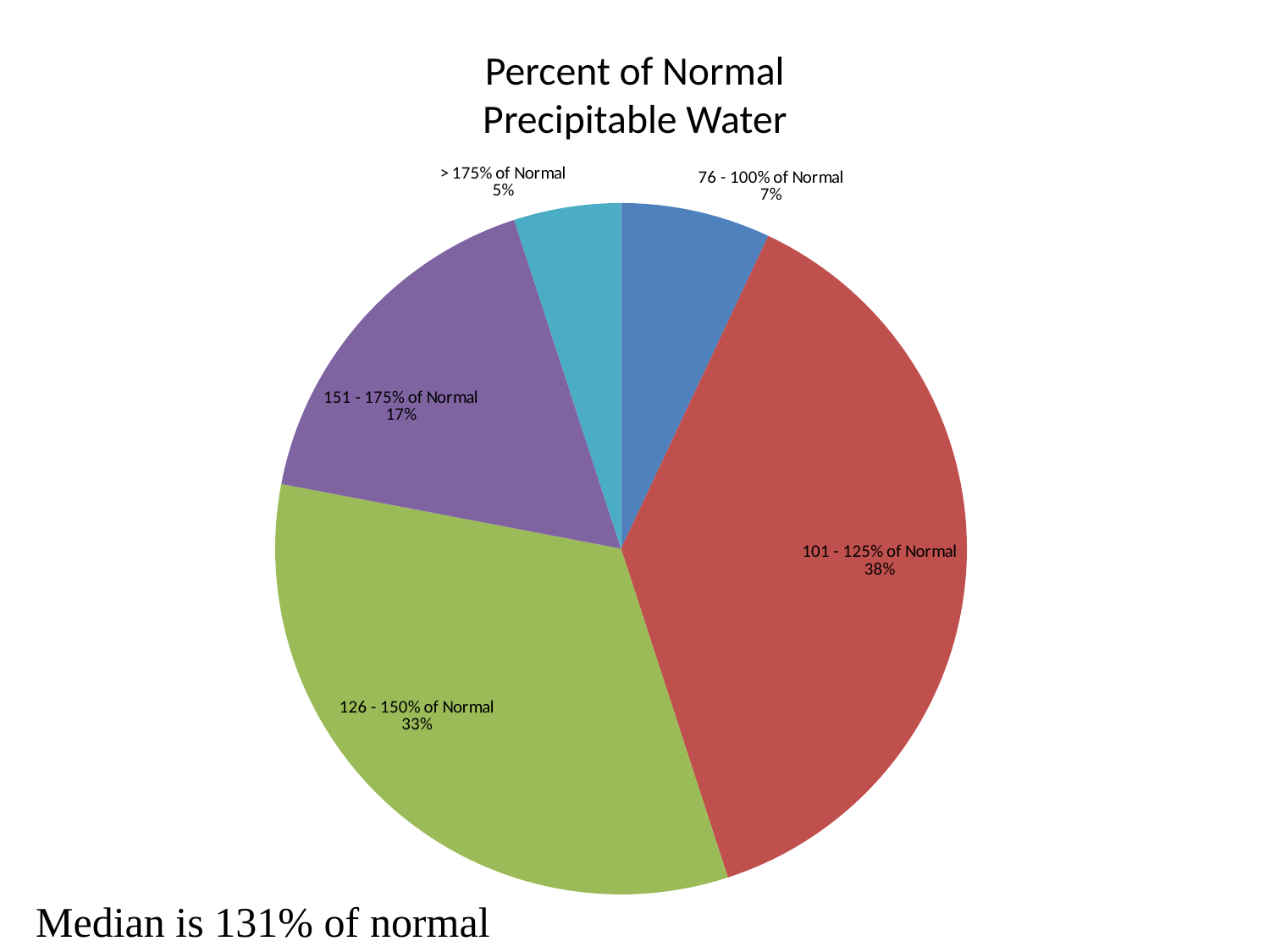
Which category has the smallest slice of the pie? > 175% of Normal What share of the pie is the 126 - 150% of Normal slice? 33% What is the difference in percentage points between the 101 - 125% of Normal slice and the 126 - 150% of Normal slice? 5 What share of the pie is the > 175% of Normal slice? 5% What share of the pie is the 101 - 125% of Normal slice? 38% What kind of chart is shown on the slide? pie chart Which slice is larger, 151 - 175% of Normal or 76 - 100% of Normal? 151 - 175% of Normal What is the title of the chart? Percent of Normal Precipitable Water Which category has the largest slice of the pie? 101 - 125% of Normal How many slices does the pie chart have? 5